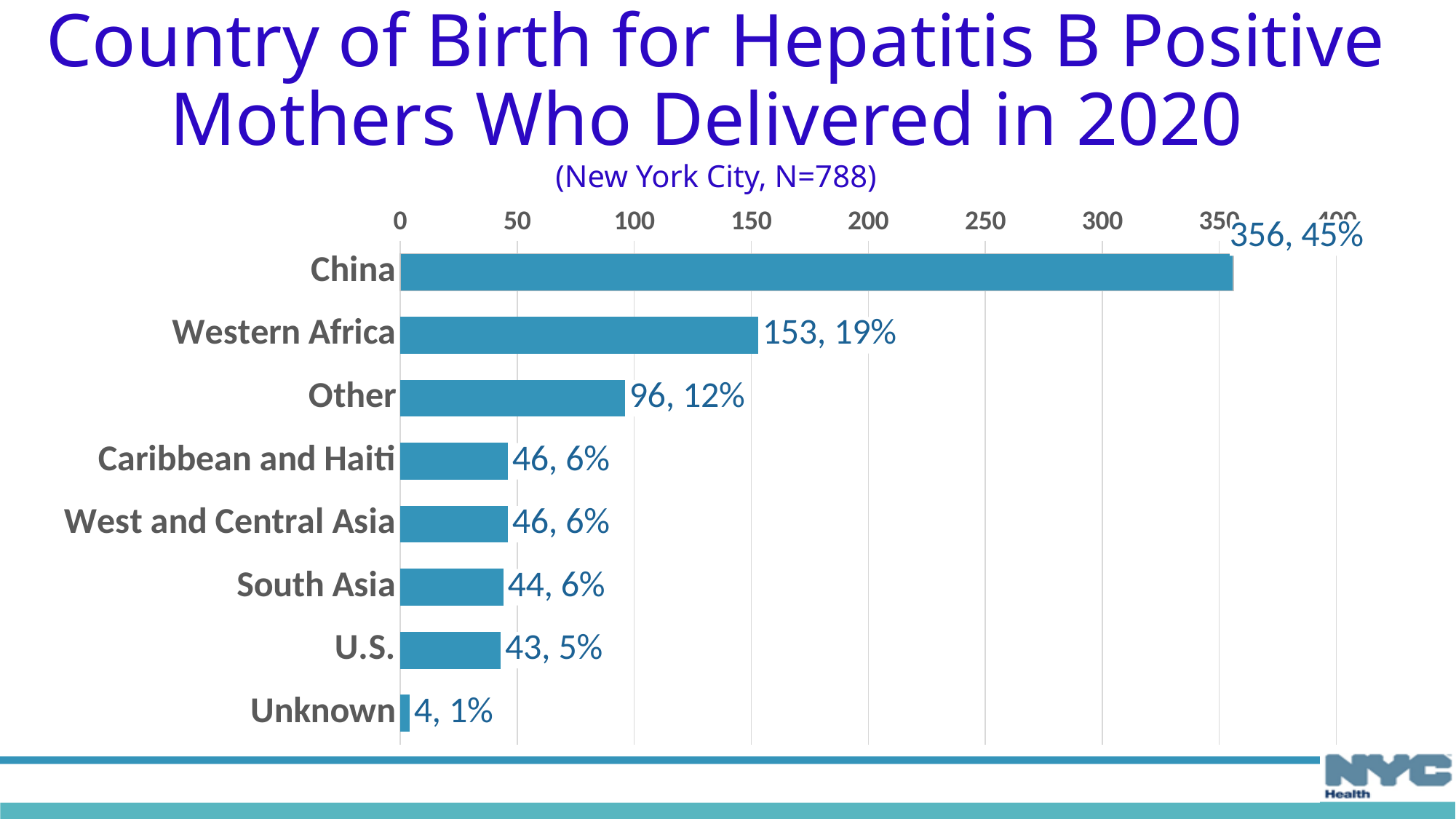
What is the difference between the counts for Other and South Asia? 52 What kind of chart is shown on the slide? bar chart How many categories are shown in the chart? 8 What percentage of mothers were born in Western Africa? 19% What is the count for the Other category? 96 Which category has the highest count? China How many mothers were born in China according to the chart? 356 Which category has the lowest count? Unknown What is the total N stated in the chart subtitle? 788 What is the count for U.S.? 43 Which has a larger count, Western Africa or Other? Western Africa What is the difference between the counts for China and Western Africa? 203